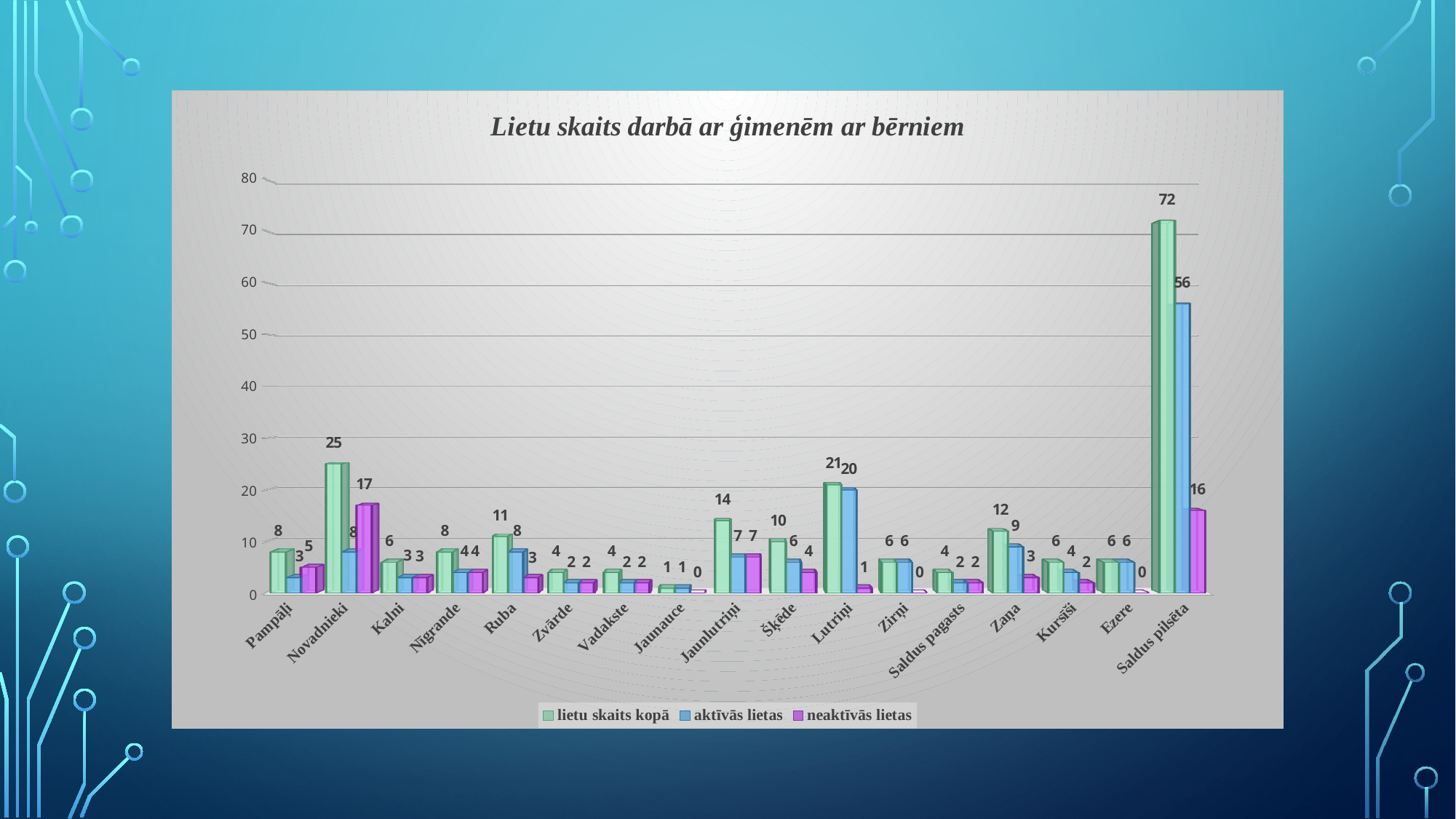
How many series does the legend list? 3 What is the value of 'aktīvās lietas' for Lutriņi? 20 Which category has the highest value for 'lietu skaits kopā'? Saldus pilsēta How many categories are shown on the x axis? 17 Which category has the lowest value for 'lietu skaits kopā'? Jaunauce What is the difference between 'lietu skaits kopā' and 'aktīvās lietas' for Saldus pilsēta? 16 Is the value of 'aktīvās lietas' for Saldus pilsēta greater or less than 50? greater What is the title of the chart? Lietu skaits darbā ar ģimenēm ar bērniem What is the value of 'lietu skaits kopā' for Saldus pilsēta? 72 What kind of chart is shown on the slide? bar chart What is the value of 'neaktīvās lietas' for Novadnieki? 17 Which is larger: 'lietu skaits kopā' for Novadnieki or for Lutriņi? Novadnieki